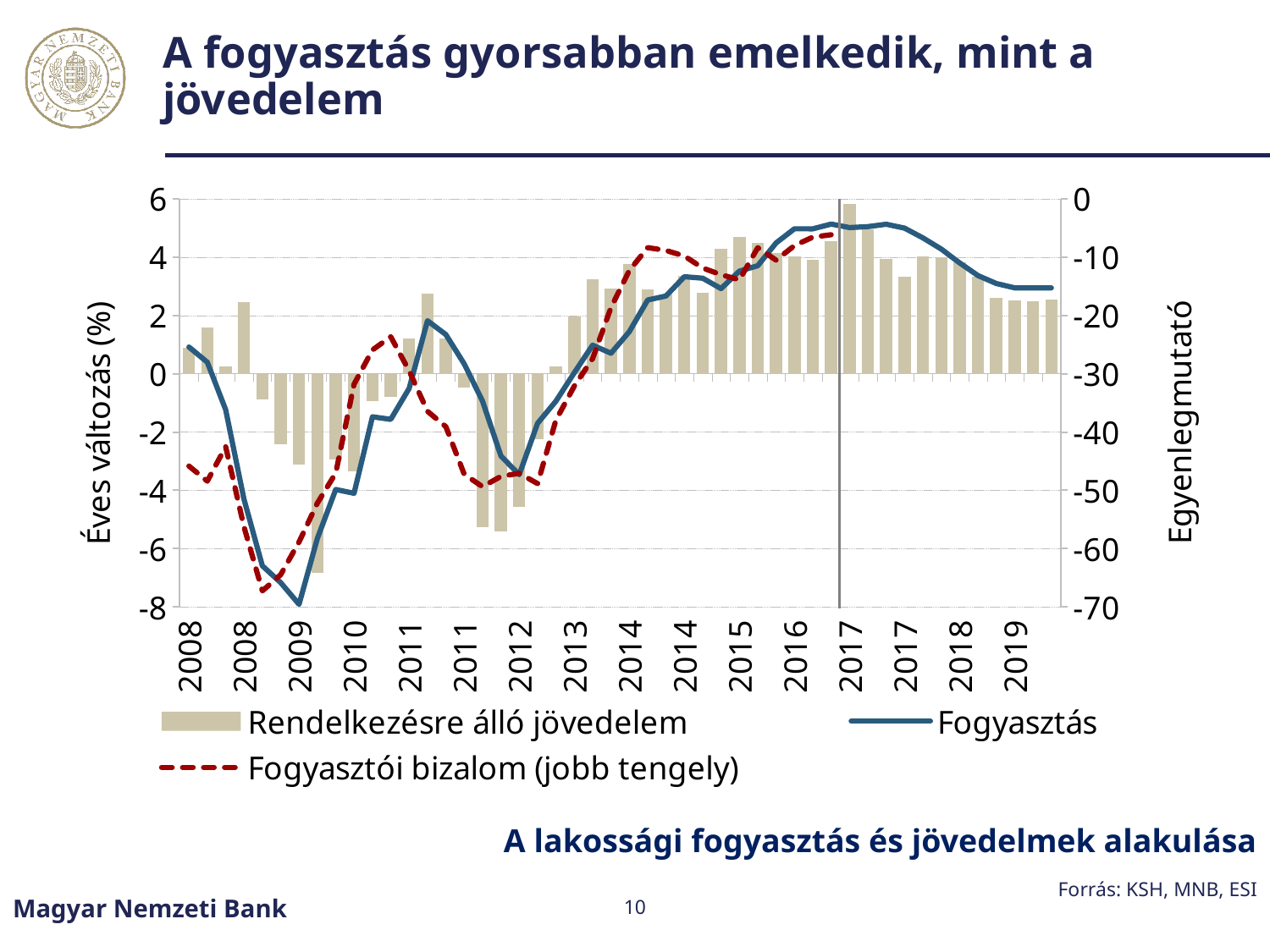
How many series does the legend list? 3 Is the lowest point of the Fogyasztás line (around 2009) greater or less than -6? less Does the Fogyasztás line rise or fall between 2012 and 2016? rise What is the label of the left vertical axis? Éves változás (%) Is the highest bar for Rendelkezésre álló jövedelem (around 2017) greater or less than 4? greater What is the title of the chart? A lakossági fogyasztás és jövedelmek alakulása Is the Fogyasztói bizalom value at the start of 2008 (right axis) greater or less than -40? less Around which year does the Fogyasztás line reach its lowest value? 2009 What kind of chart is shown on the slide? A combined bar and line chart Which series is plotted on the right axis according to the legend? Fogyasztói bizalom (jobb tengely) Does the Fogyasztás line rise or fall between 2017 and 2019? fall